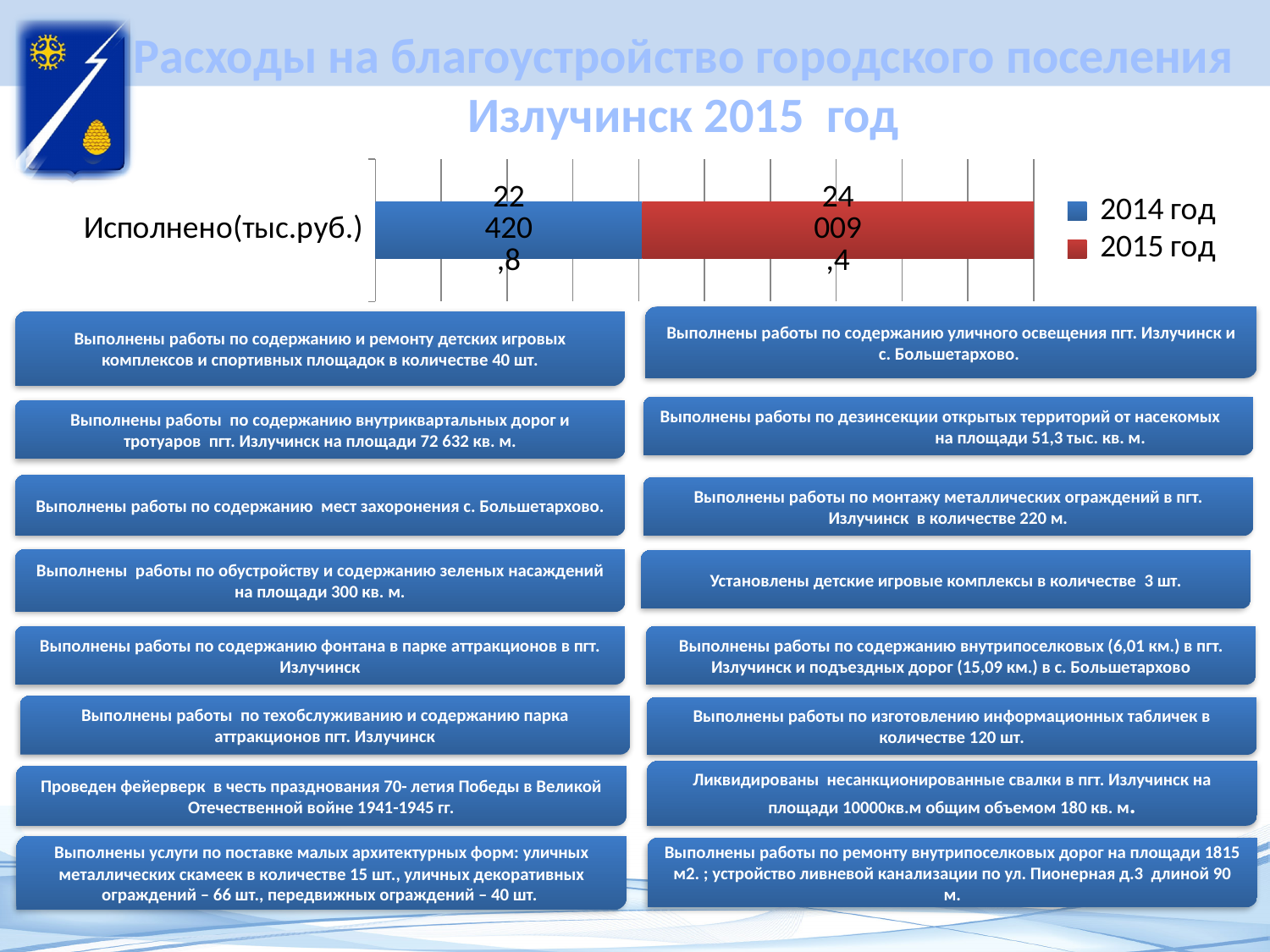
What is the value for 2015 год in the chart? 24 009,4 What is the label of the category plotted in the chart? Исполнено(тыс.руб.) Which colour represents 2015 год in the chart? red What is the value for 2014 год in the chart? 22 420,8 Which series has the larger value, 2014 год or 2015 год? 2015 год Which series has the highest value in the chart? 2015 год What is the difference between the 2015 год value and the 2014 год value? 1 588,6 How many categories are plotted in the chart? 1 How many series does the legend list? 2 Which series has the lowest value in the chart? 2014 год What kind of chart is shown on the slide? bar chart What is the total of the stacked bar for Исполнено(тыс.руб.)? 46 430,2